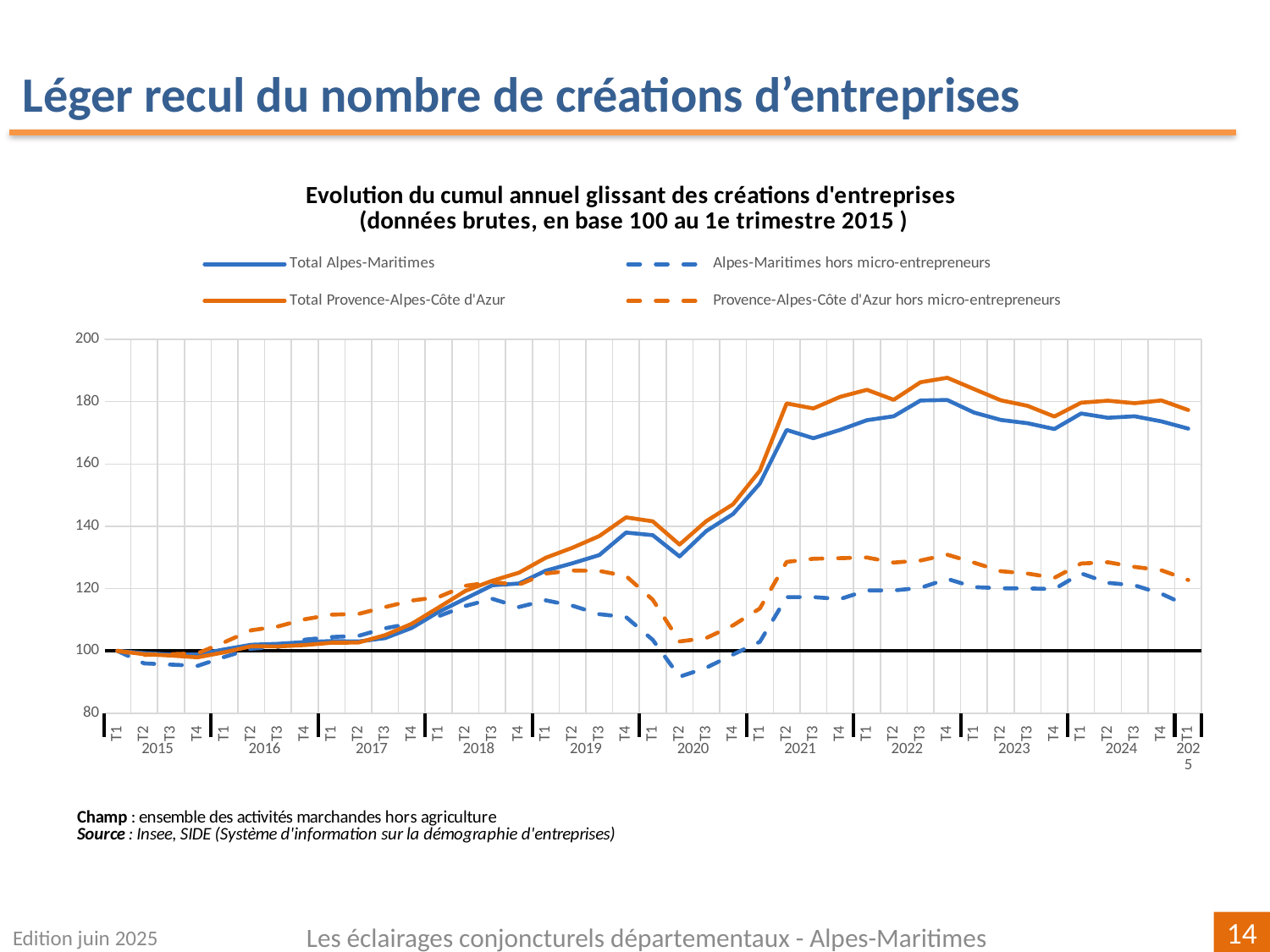
At T2 2020, which is higher: Alpes-Maritimes hors micro-entrepreneurs or Provence-Alpes-Côte d'Azur hors micro-entrepreneurs? Provence-Alpes-Côte d'Azur hors micro-entrepreneurs Is the value for Total Provence-Alpes-Côte d'Azur at T4 2022 greater or less than 180? greater What kind of chart is shown on the slide? line chart Does the Total Alpes-Maritimes series rise or fall between T1 2015 and T4 2022? rise Is the value for Total Alpes-Maritimes at T1 2025 greater or less than 160? greater Which line style is used for the 'hors micro-entrepreneurs' series in the legend? dashed What is the value of the Total Alpes-Maritimes series at T1 2015? 100 Is the value for Alpes-Maritimes hors micro-entrepreneurs at T2 2020 greater or less than 100? less Does the Total Alpes-Maritimes series rise or fall between T4 2022 and T1 2025? fall At T4 2022, which is higher: Total Provence-Alpes-Côte d'Azur or Total Alpes-Maritimes? Total Provence-Alpes-Côte d'Azur How many series does the legend list? 4